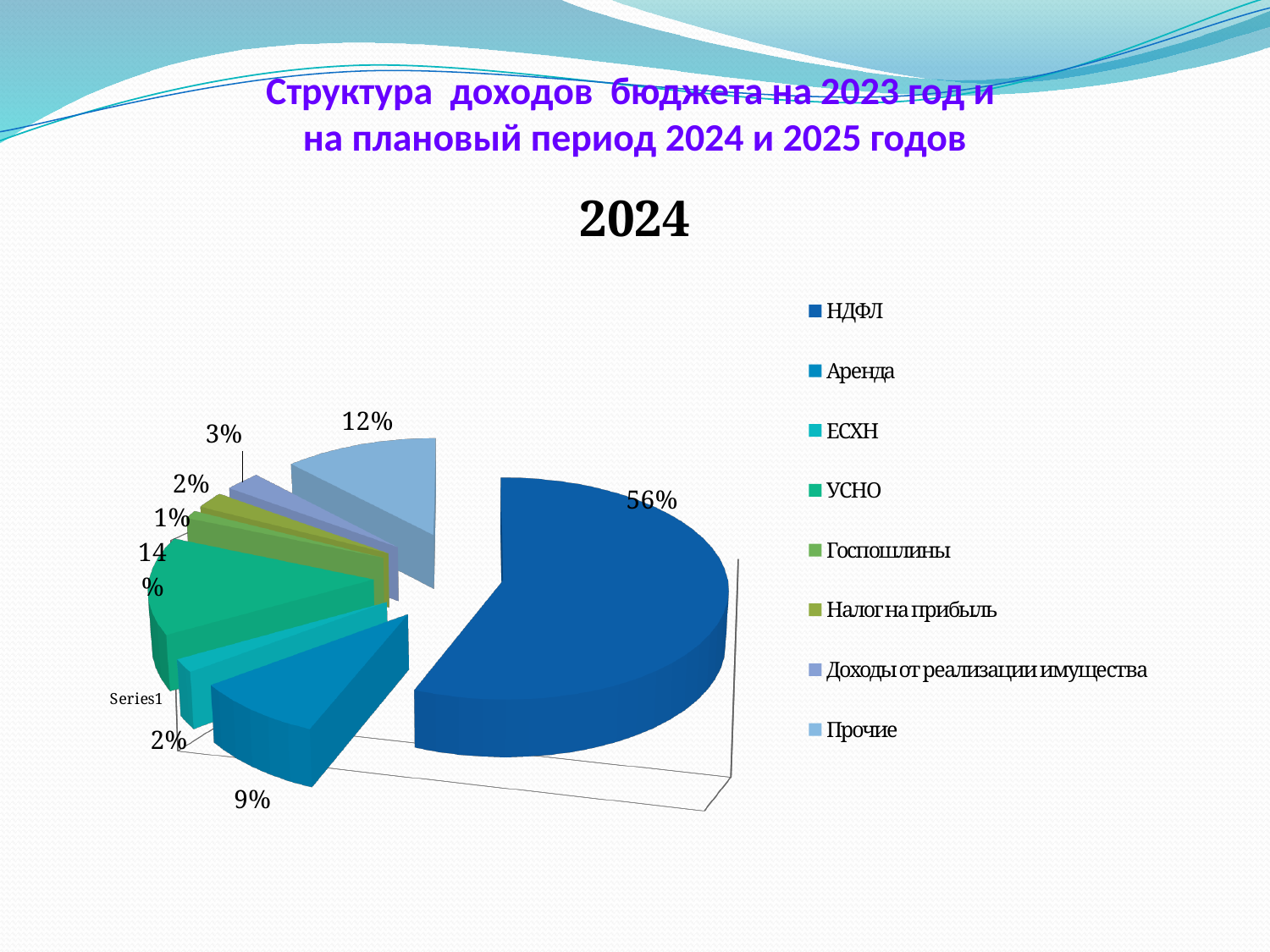
Which category has the largest share of the pie? НДФЛ What share of the pie does УСНО have? 14% How many entries does the chart legend list? 8 What share of the pie does Прочие have? 12% What is the title of the chart? 2024 What type of chart is shown on the slide? pie chart What is the difference between the shares of УСНО and Прочие? 2% What share of the pie does НДФЛ have? 56% Which category has the smallest share of the pie? Госпошлины What share of the pie does Аренда have? 9% What share of the pie does Доходы от реализации имущества have? 3% What share of the pie does Госпошлины have? 1%